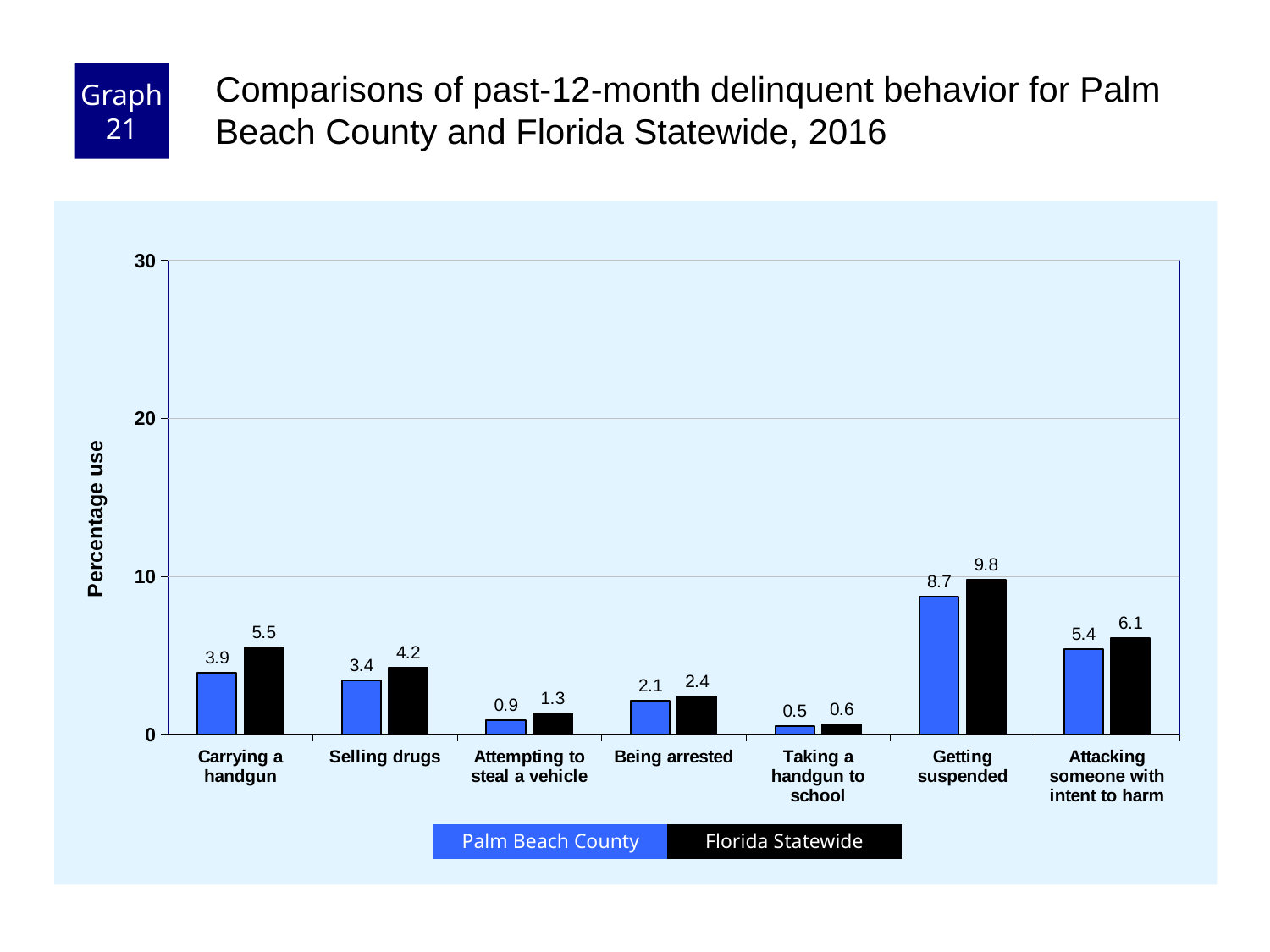
Which category has the highest Florida Statewide value? Getting suspended Which is larger for Selling drugs: Palm Beach County or Florida Statewide? Florida Statewide What is the difference between the Florida Statewide and Palm Beach County values for Carrying a handgun? 1.6 Is the Florida Statewide value for Getting suspended greater or less than 10? less How many categories are shown on the x axis? 7 How many series does the legend list? 2 What is the Palm Beach County value for Taking a handgun to school? 0.5 What is the Florida Statewide value for Carrying a handgun? 5.5 Which category has the lowest Palm Beach County value? Taking a handgun to school What is the label of the y axis? Percentage use What is the Palm Beach County value for Getting suspended? 8.7 What kind of chart is shown on the slide? bar chart